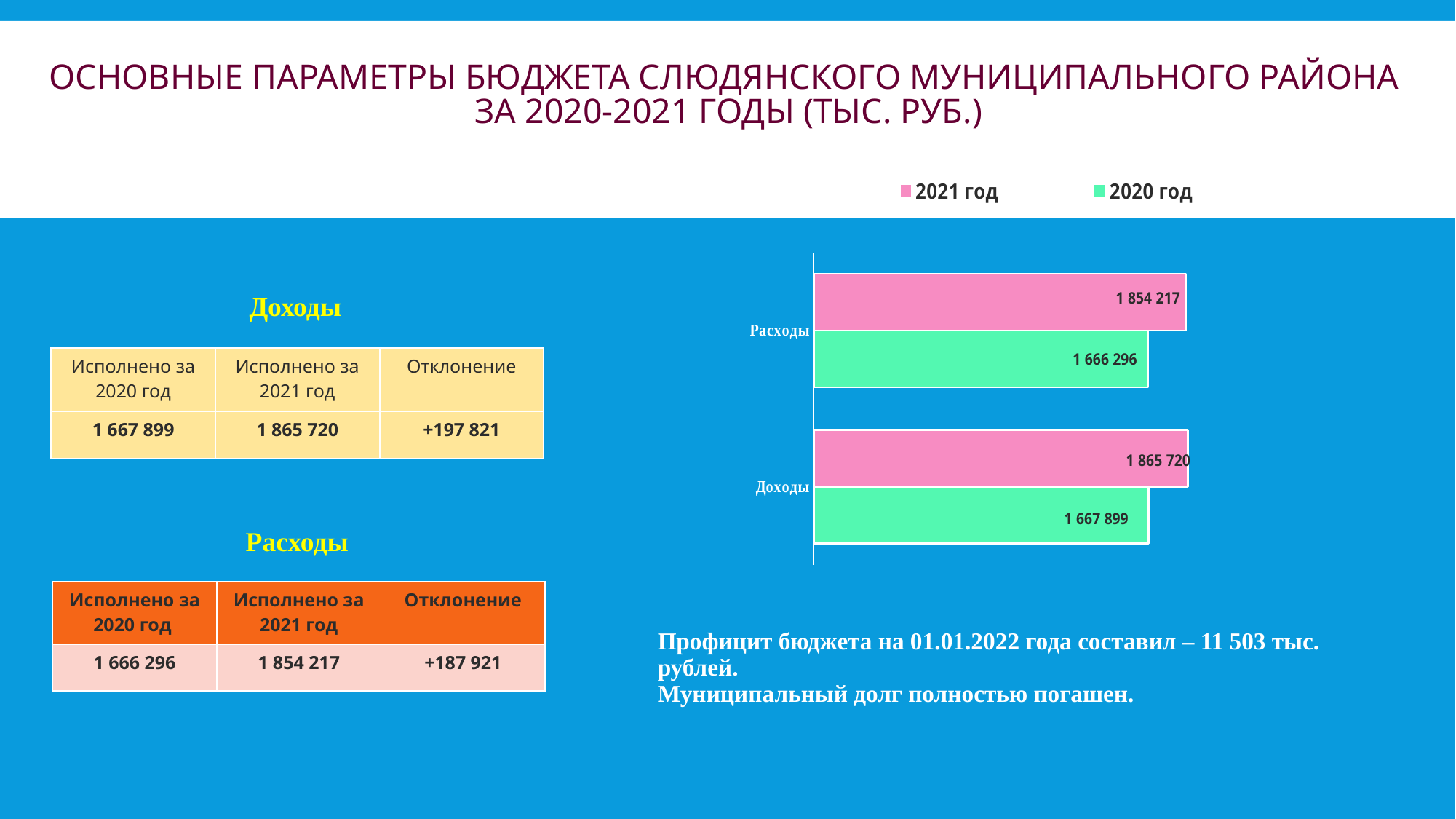
Which category has the lowest value in the 2020 год series? Расходы How many series does the chart legend list? 2 What is the difference between the 2021 год and 2020 год values for Расходы? 187 921 Which colour represents the 2020 год series in the chart? green What is the value for Доходы in the 2021 год series? 1 865 720 What type of chart is shown on the slide? bar chart Which category has the highest value in the 2021 год series? Доходы What is the value for Доходы in the 2020 год series? 1 667 899 How many categories are plotted in the chart? 2 What is the value for Расходы in the 2020 год series? 1 666 296 What is the difference between the 2021 год and 2020 год values for Доходы? 197 821 What is the value for Расходы in the 2021 год series? 1 854 217